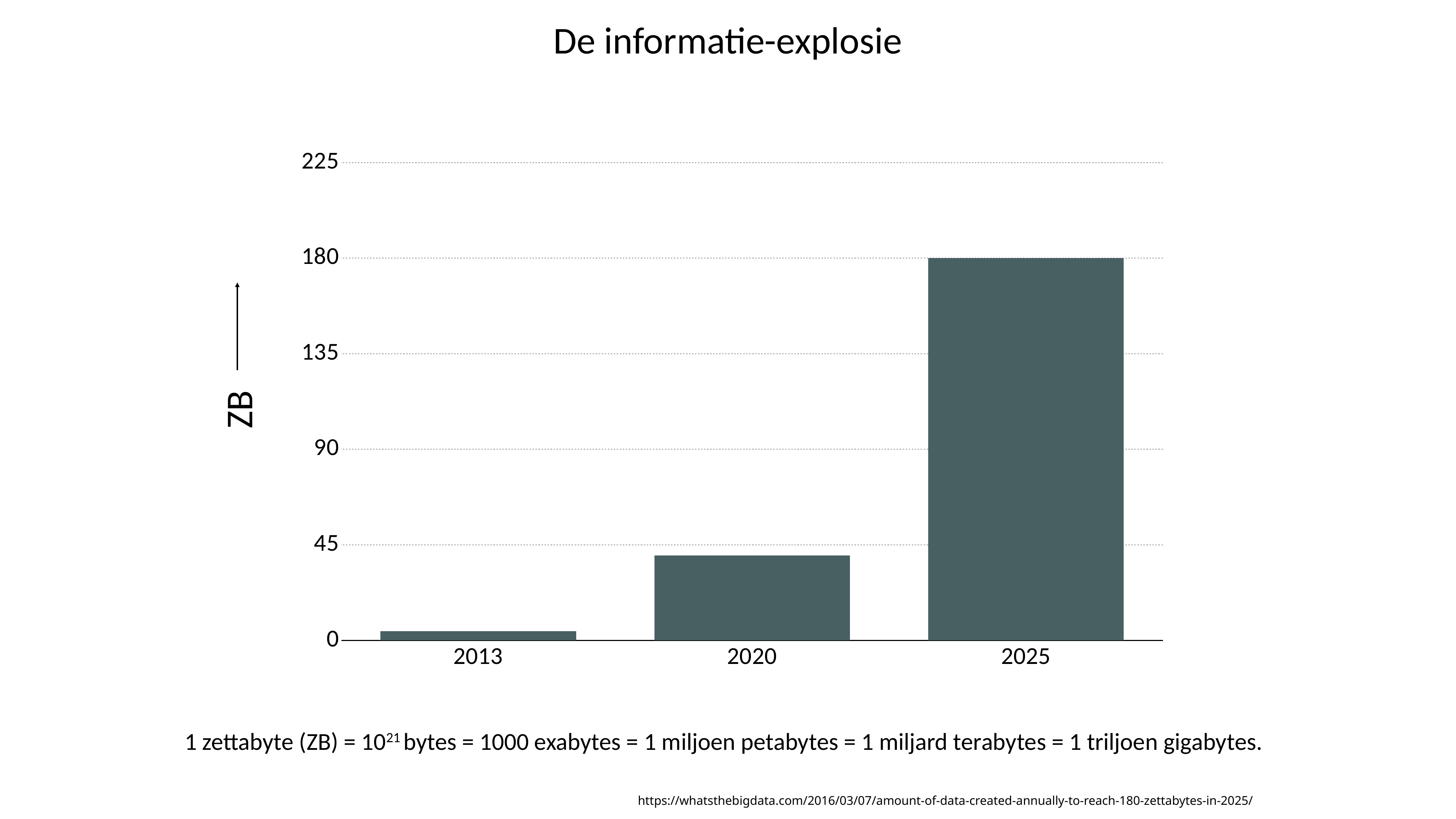
What is the value for 2025 in ZB? 180 Which is larger, the value for 2020 or the value for 2013? 2020 What unit is shown on the vertical axis label? ZB What kind of chart is shown on the slide? bar chart Is the value for 2020 greater or less than 45? less Do the values rise or fall from 2013 to 2025? rise Which year has the lowest value in the chart? 2013 Is the value for 2025 greater or less than 135? greater What is the title of the slide? De informatie-explosie Is the value for 2013 greater or less than 45? less Which year has the highest value in the chart? 2025 How many bars (years) are plotted in the chart? 3